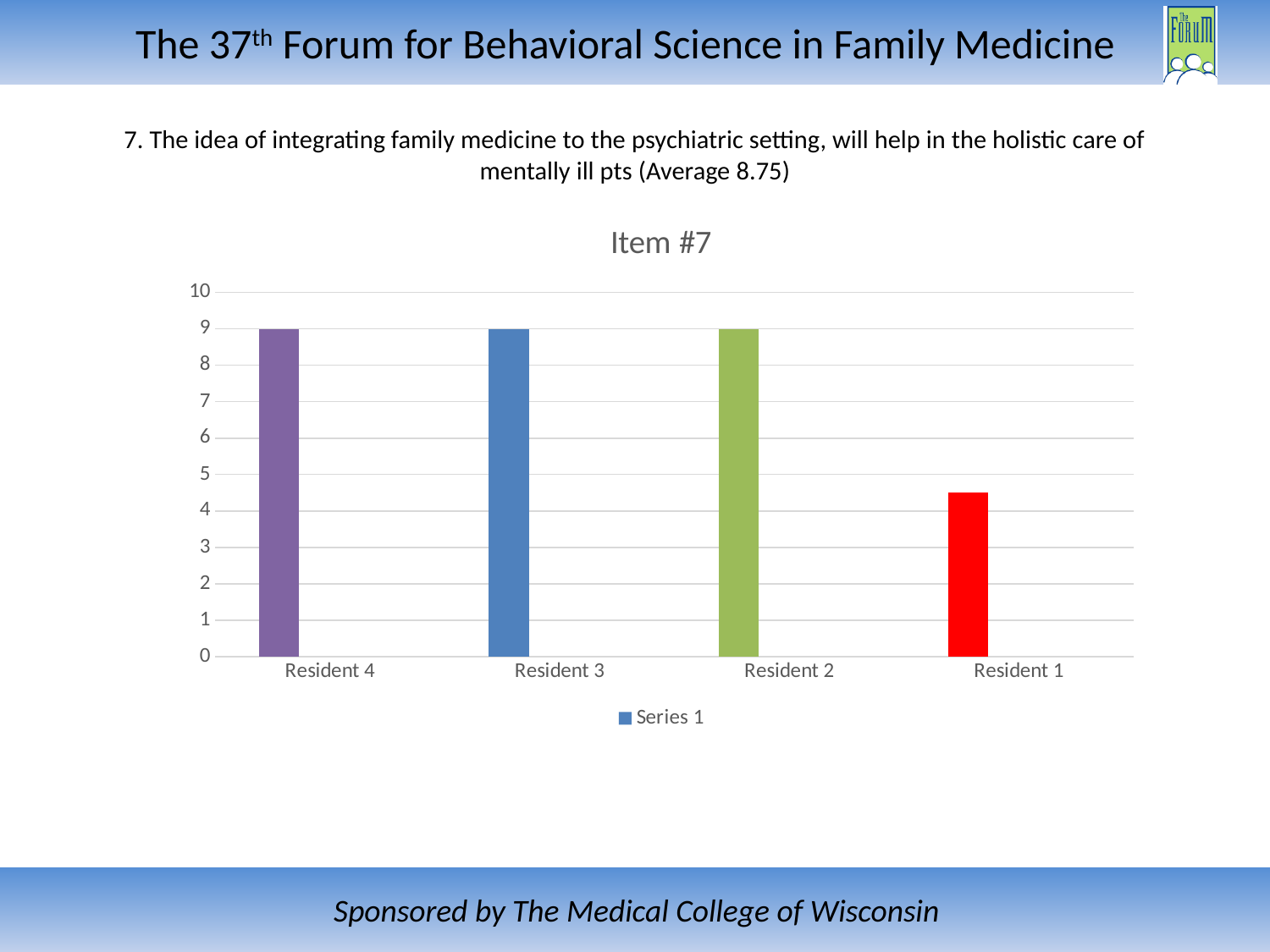
What is the value for Resident 2 in the Item #7 chart? 9 What is the value for Resident 4 in the Item #7 chart? 9 What is the name of the series listed in the chart legend? Series 1 What is the value for Resident 3 in the Item #7 chart? 9 What kind of chart is shown on the slide? Bar chart Is the value for Resident 1 greater or less than 5? less How many residents are shown on the x axis of the Item #7 chart? 4 Is the value for Resident 1 greater or less than 4? greater What is the title of the chart on the slide? Item #7 Which has a larger value, Resident 2 or Resident 1? Resident 2 How many series does the legend of the Item #7 chart list? 1 Which resident has the lowest value in the Item #7 chart? Resident 1